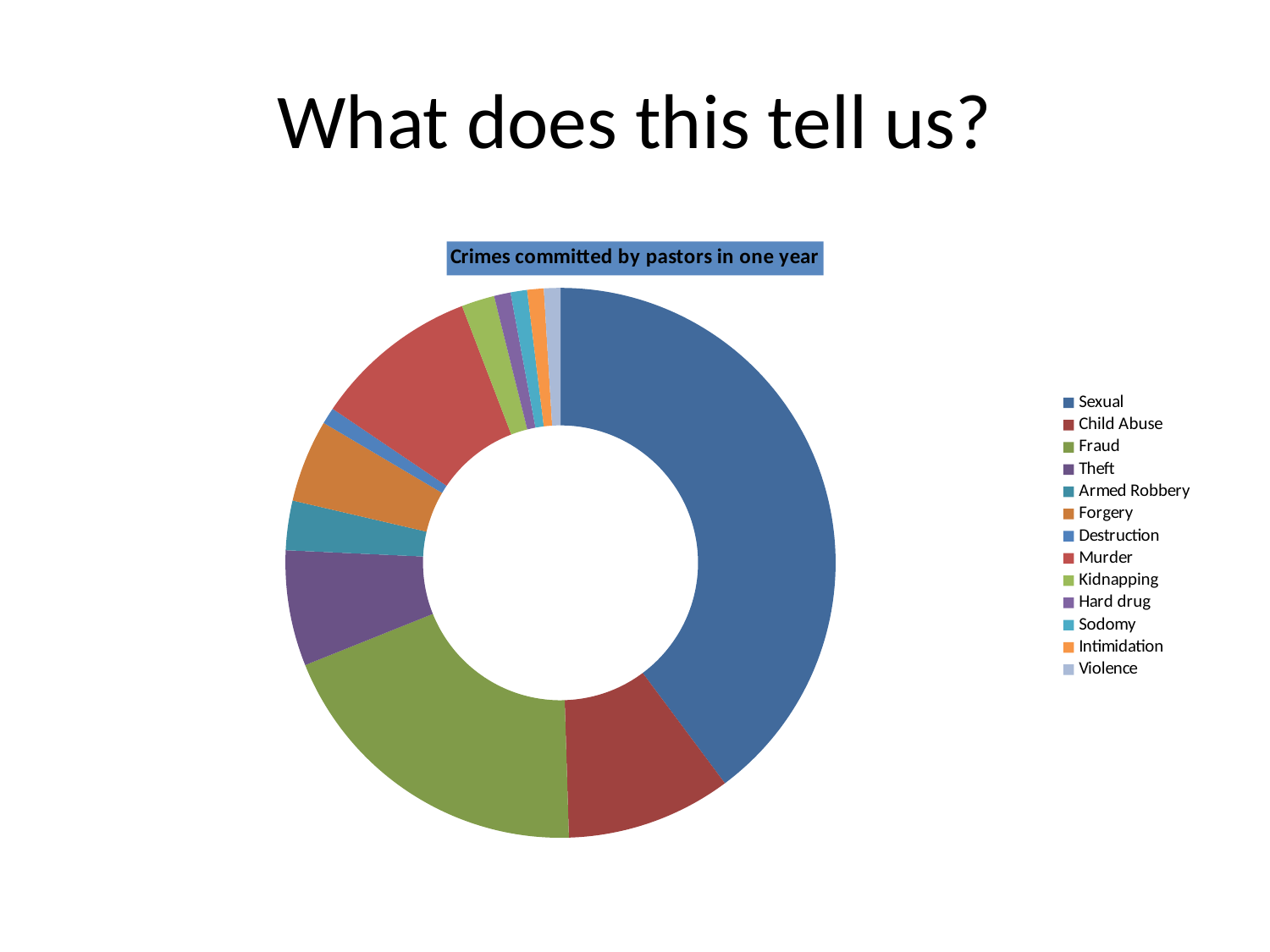
What kind of chart is shown on the slide? Pie chart (doughnut) What colour is the Sexual slice in the chart? Blue What is the title of the chart? Crimes committed by pastors in one year How many categories does the chart's legend list? 13 Which slice is larger, Child Abuse or Theft? Child Abuse Which slice is larger, Theft or Armed Robbery? Theft Which slice is larger, Murder or Forgery? Murder Which category has the largest slice of the chart? Sexual